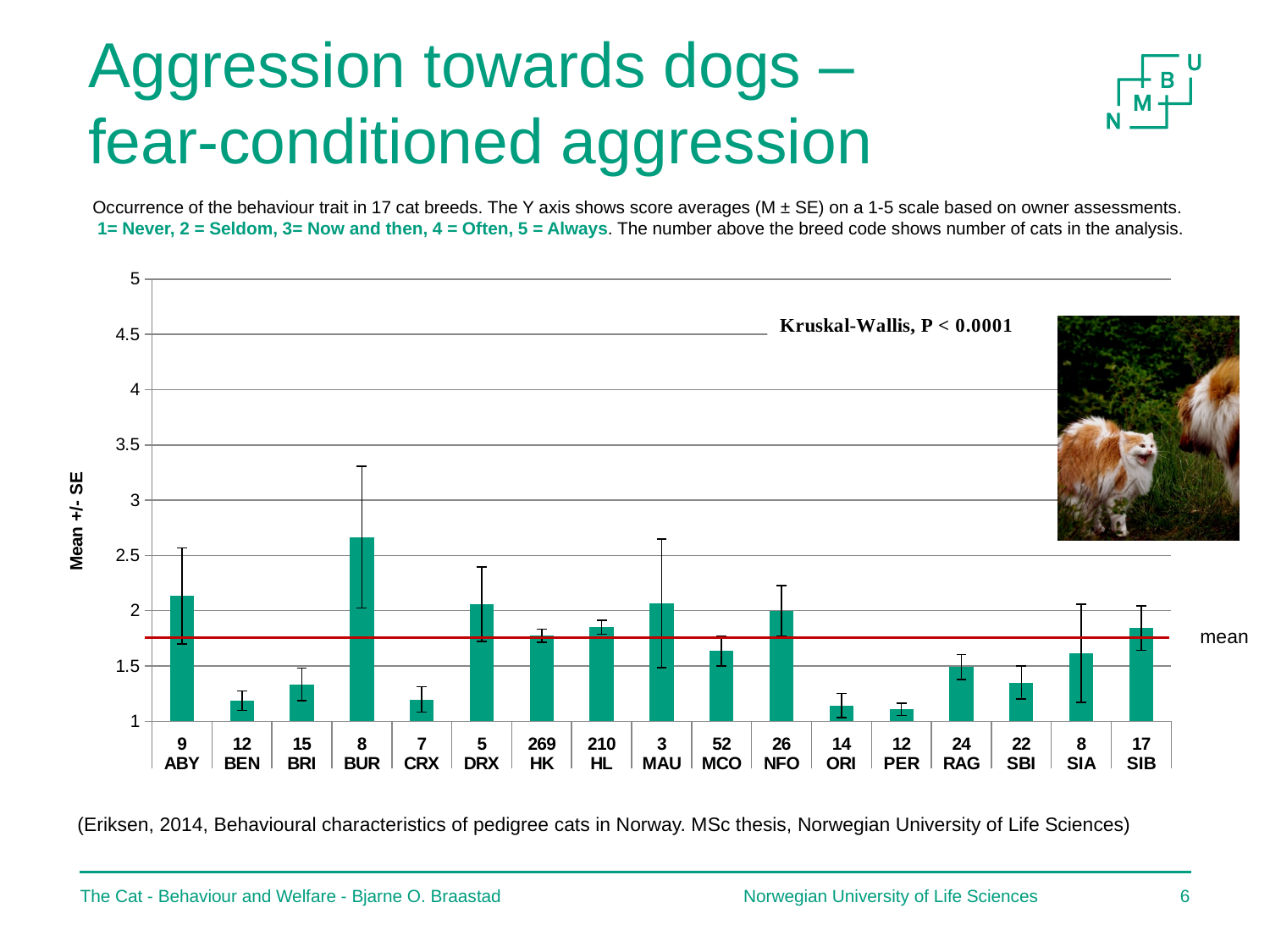
Is the mean score for HK greater or less than 2? less What is the label of the y axis of the chart? Mean +/- SE Which breed has a higher mean score, BUR or ABY? BUR Which breed has the highest mean score in the chart? BUR Is the mean score for SBI greater or less than 1.5? less What kind of chart is shown on the slide? bar chart Which breed has a higher mean score, BEN or BRI? BRI Is the mean score for ABY greater or less than 2? greater How many cat breeds are plotted on the x axis of the chart? 17 According to the number printed above the breed code, how many cats of breed HK were in the analysis? 269